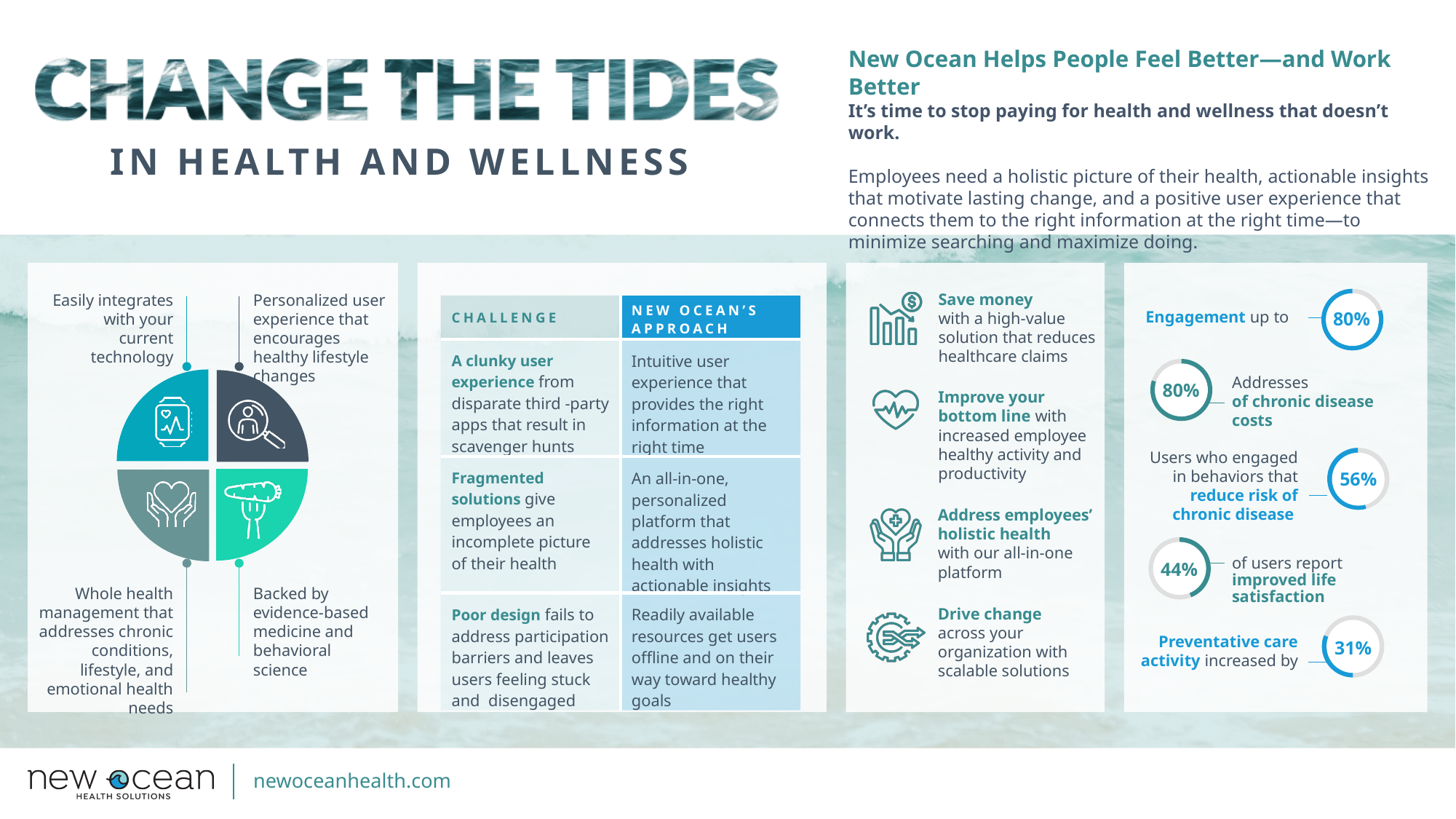
On the right-hand panel of ring charts, which is larger: the value for improved life satisfaction or the value for preventative care activity? Improved life satisfaction On the right-hand panel of ring charts, what value is shown for Engagement? 80% On the right-hand panel of ring charts, what is the difference between the value for users who engaged in behaviors that reduce risk of chronic disease and the value for users who report improved life satisfaction? 12% On the right-hand panel of ring charts, what percentage of chronic disease costs is addressed? 80% On the right-hand panel of ring charts, by what percentage did preventative care activity increase? 31% On the right-hand panel, what kind of chart is used to display each percentage? Ring (donut) chart On the right-hand panel of ring charts, what percentage of users report improved life satisfaction? 44% On the right-hand panel of ring charts, is the value for users who engaged in behaviors that reduce risk of chronic disease greater or less than 50%? greater On the right-hand panel of ring charts, what percentage is shown for users who engaged in behaviors that reduce risk of chronic disease? 56% On the right-hand panel of ring charts, which statistic has the lowest value? Preventative care activity increased by On the right-hand panel of ring charts, what is the difference between the Engagement value and the preventative care activity value? 49% On the right-hand panel of ring charts, how many ring charts are shown? 5